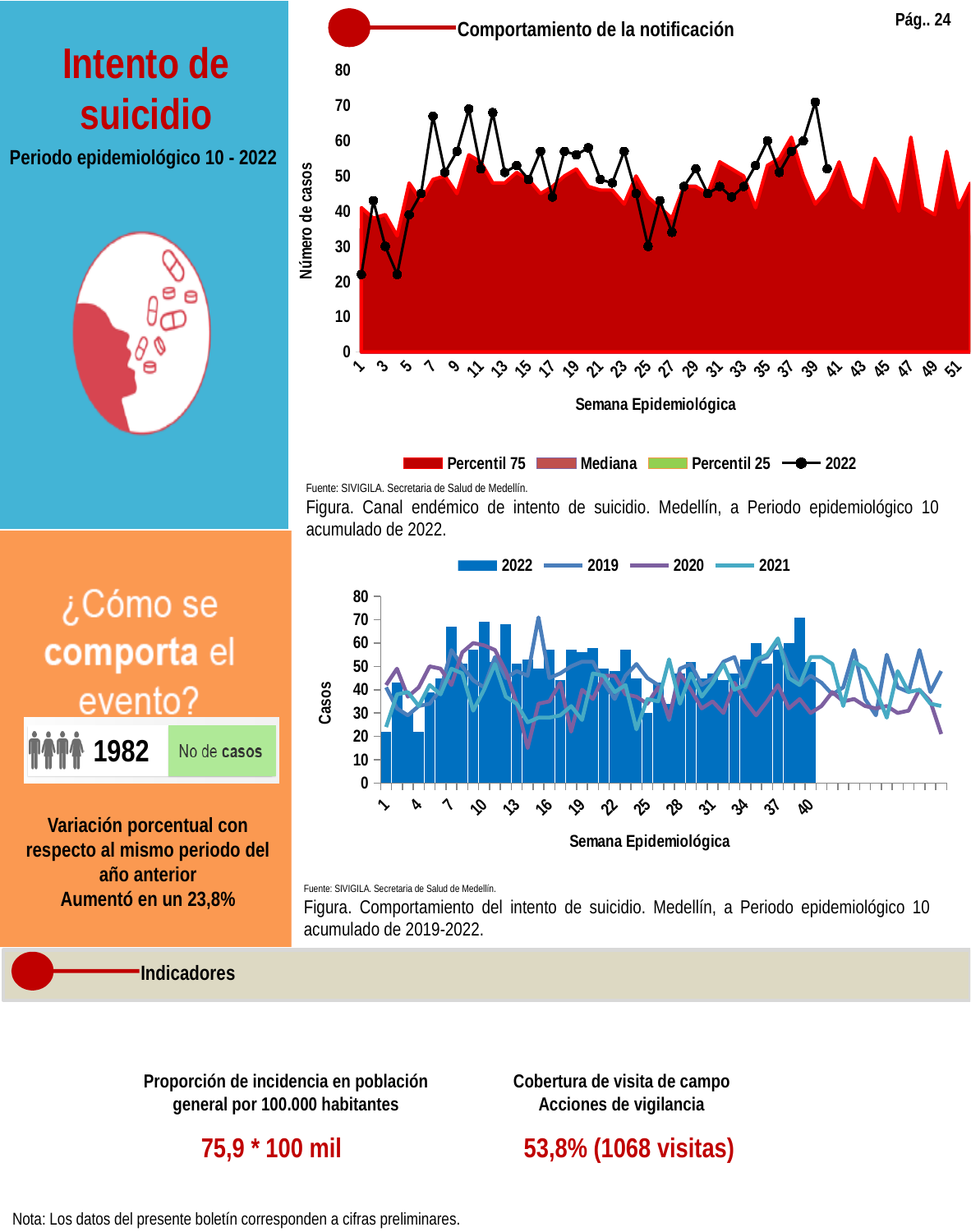
In the bottom chart (Comportamiento del intento de suicidio 2019-2022), which is larger for the 2022 series: week 7 or week 4? week 7 In the top chart 'Comportamiento de la notificación', what is the label of the y axis? Número de casos In the bottom chart (Comportamiento del intento de suicidio 2019-2022), how many bars are plotted for the 2022 series? 40 In the top chart 'Comportamiento de la notificación', is the 2022 value for week 1 greater or less than 30? less In the top chart 'Comportamiento de la notificación', which is larger for the 2022 series: week 39 or week 1? week 39 In the top chart 'Comportamiento de la notificación', is the 2022 value for week 7 greater or less than 60? greater In the top chart 'Comportamiento de la notificación', how many series does the legend list? 4 In the top chart 'Comportamiento de la notificación', is the 2022 value for week 39 greater or less than 60? greater In the bottom chart (Comportamiento del intento de suicidio 2019-2022), how many series does the legend list? 4 In the top chart 'Comportamiento de la notificación', what are the legend entries? Percentil 75, Mediana, Percentil 25, 2022 In the bottom chart (Comportamiento del intento de suicidio 2019-2022), which series is drawn as bars? 2022